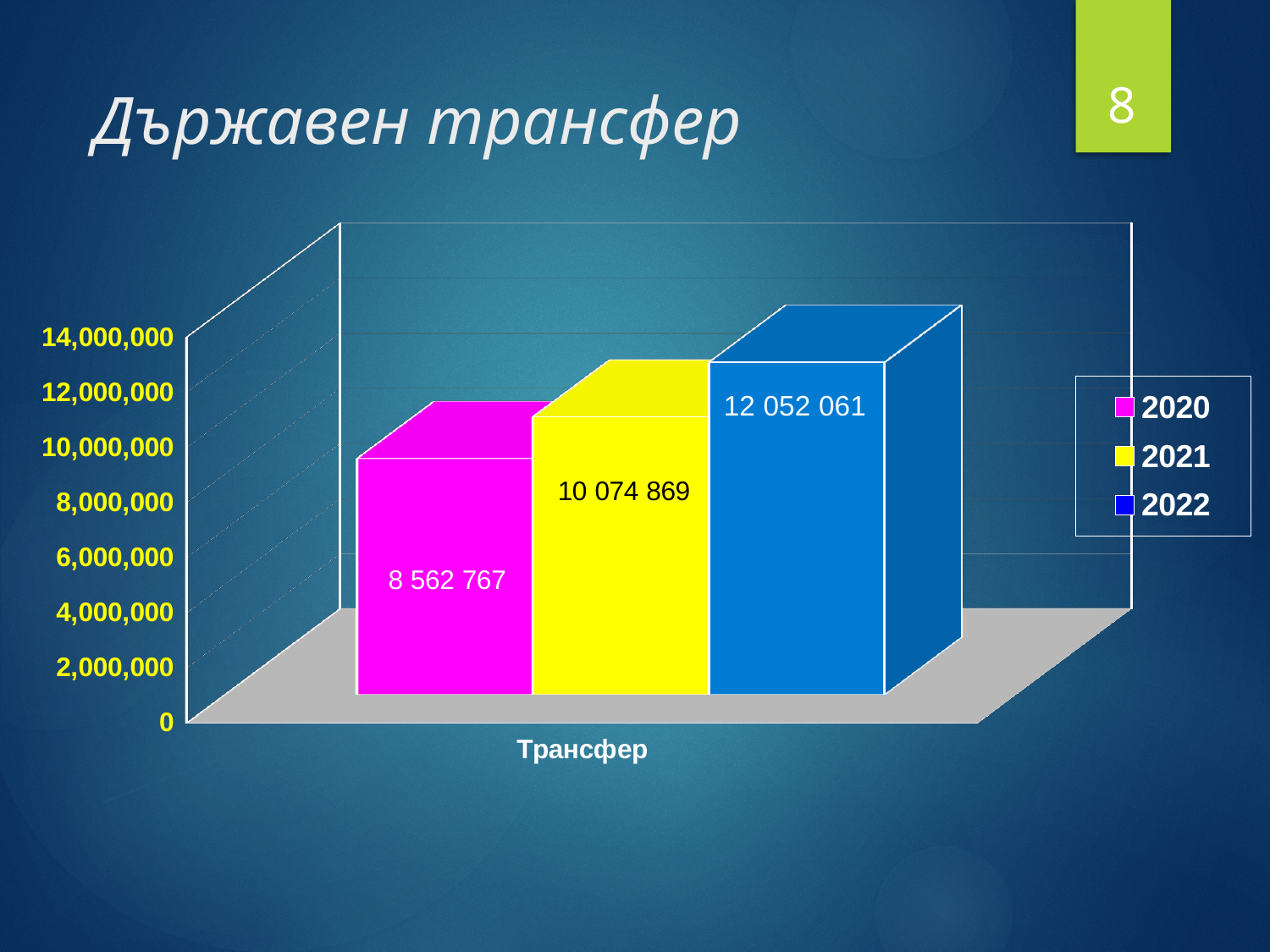
What is the title of the slide containing the chart? Държавен трансфер What is the value for 2021 in the chart? 10 074 869 What is the difference between the values for 2022 and 2021? 1 977 192 Is the value for 2021 greater or less than 10,000,000? greater Which is larger, the value for 2020 or the value for 2022? 2022 How many series does the legend list? 3 What is the value for 2022 in the chart? 12 052 061 Which year has the lowest value in the chart? 2020 What is the value for 2020 in the chart? 8 562 767 What is the difference between the values for 2021 and 2020? 1 512 102 Which year has the highest value in the chart? 2022 What kind of chart is shown on the slide? Bar chart